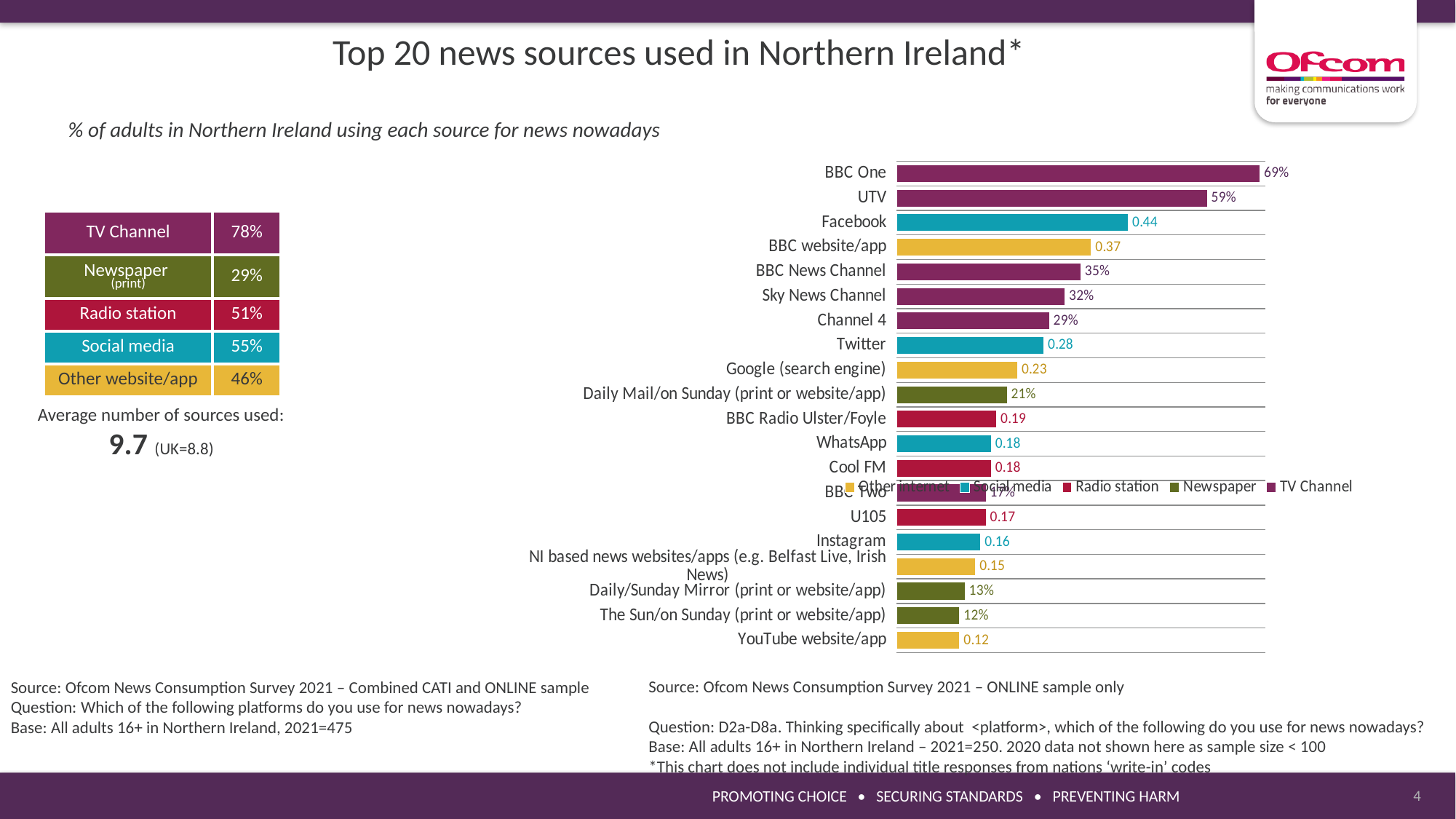
Which news source has the lowest value in the bar chart? The Sun/on Sunday (print or website/app) and YouTube website/app (both 12%) Which news source has the highest value in the bar chart? BBC One What is the value for BBC One in the bar chart? 69% What is the difference between the values for BBC One and UTV? 10% What is the value shown for Sky News Channel? 32% What is the value shown for Facebook in the bar chart? 0.44 What is the value shown for YouTube website/app? 0.12 How many series does the chart legend list? 5 Which has a larger value, BBC News Channel or Channel 4? BBC News Channel What type of chart is used to show the top 20 news sources? Bar chart How many news sources are plotted in the bar chart? 20 Which legend entry is shown in yellow? Other internet